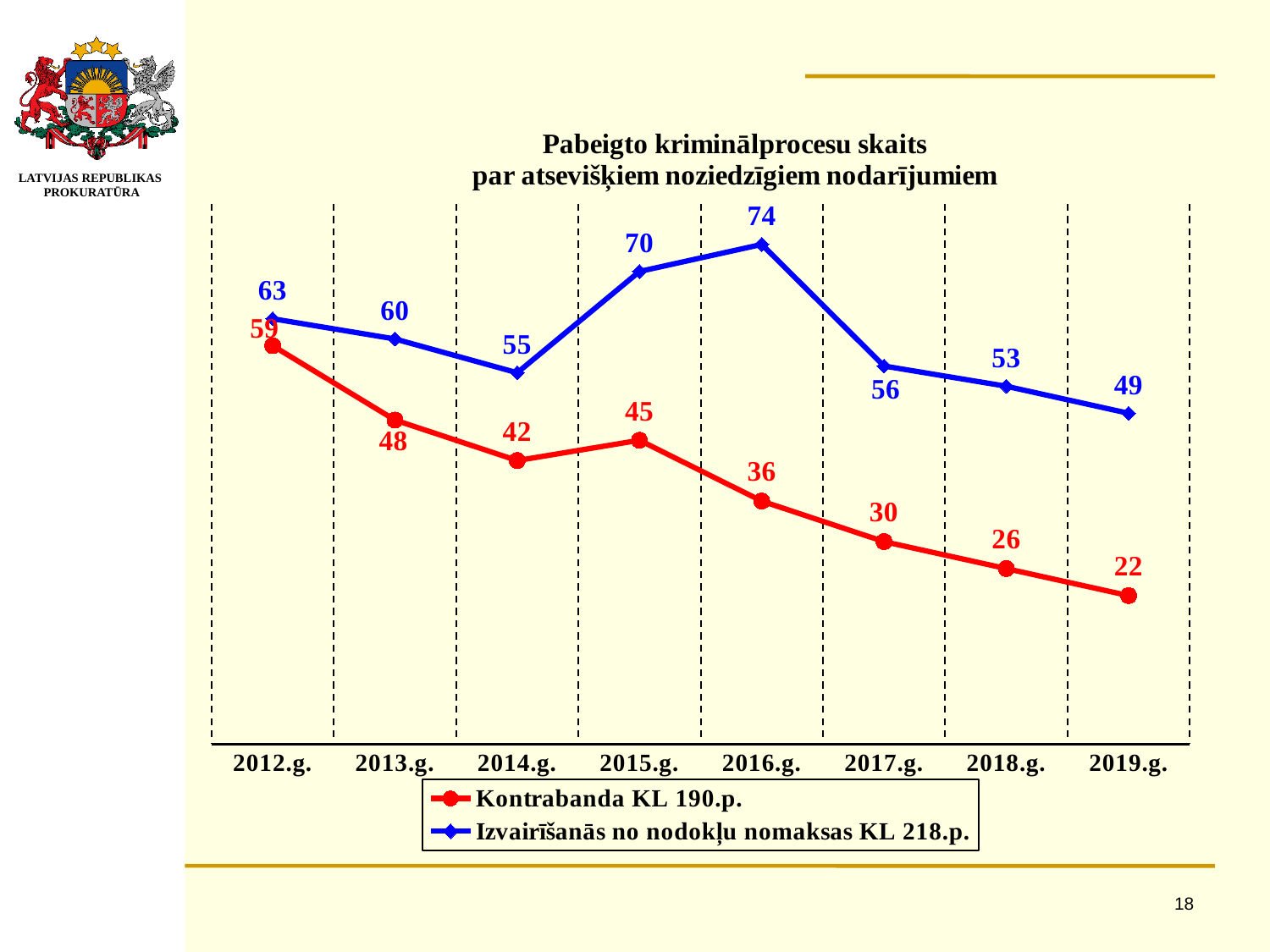
What is the difference between the two series in 2019.g.? 27 What kind of chart is shown on the slide? line chart How many series does the legend list? 2 By how much did the value for Kontrabanda KL 190.p. fall from 2012.g. to 2019.g.? 37 Which colour is used for the Izvairīšanās no nodokļu nomaksas KL 218.p. line? blue In which year is the value for Izvairīšanās no nodokļu nomaksas KL 218.p. highest? 2016.g. Which series has the larger value in 2015.g.? Izvairīšanās no nodokļu nomaksas KL 218.p. Does the value for Kontrabanda KL 190.p. generally rise or fall from 2012.g. to 2019.g.? fall How many years are shown on the x axis? 8 In which year is the value for Kontrabanda KL 190.p. lowest? 2019.g. What is the value for Kontrabanda KL 190.p. in 2016.g.? 36 What is the value for Izvairīšanās no nodokļu nomaksas KL 218.p. in 2014.g.? 55